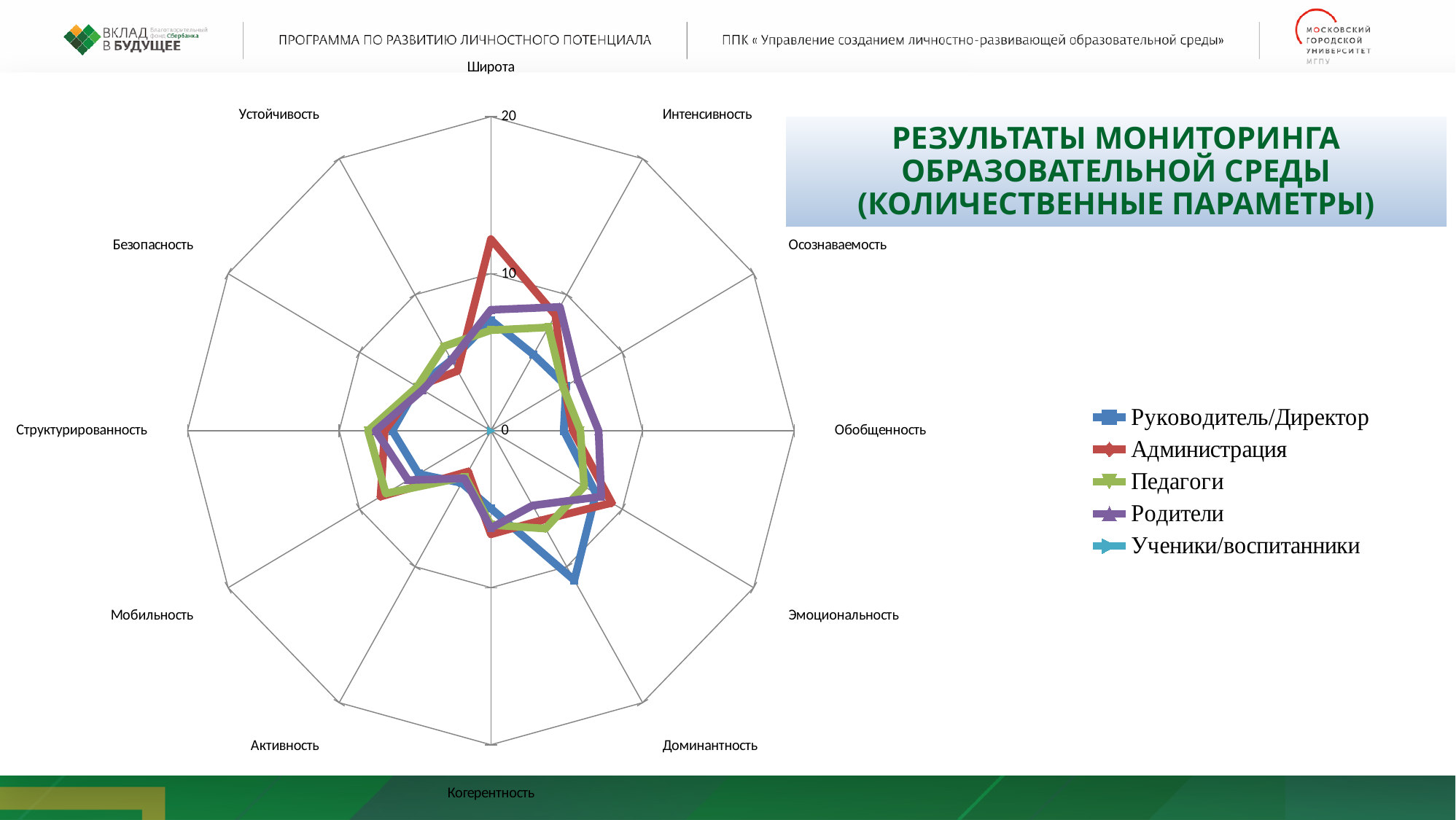
What colour is used for the Педагоги series? green Is the value for Администрация on the Широта axis greater or less than 10? greater How many parameter axes (categories) does the radar chart have? 12 Which series has the lowest values overall, sitting at the centre of the chart? Ученики/воспитанники On the Широта axis, which is larger: the value for Администрация or for Руководитель/Директор? Администрация Which series has the highest value on the Широта axis? Администрация What kind of chart is shown on the slide? radar chart Is the value for Родители on the Обобщенность axis greater or less than 10? less Is the value for Руководитель/Директор on the Широта axis greater or less than 10? less How many series does the legend list? 5 On which axis does the Администрация series reach its highest value? Широта